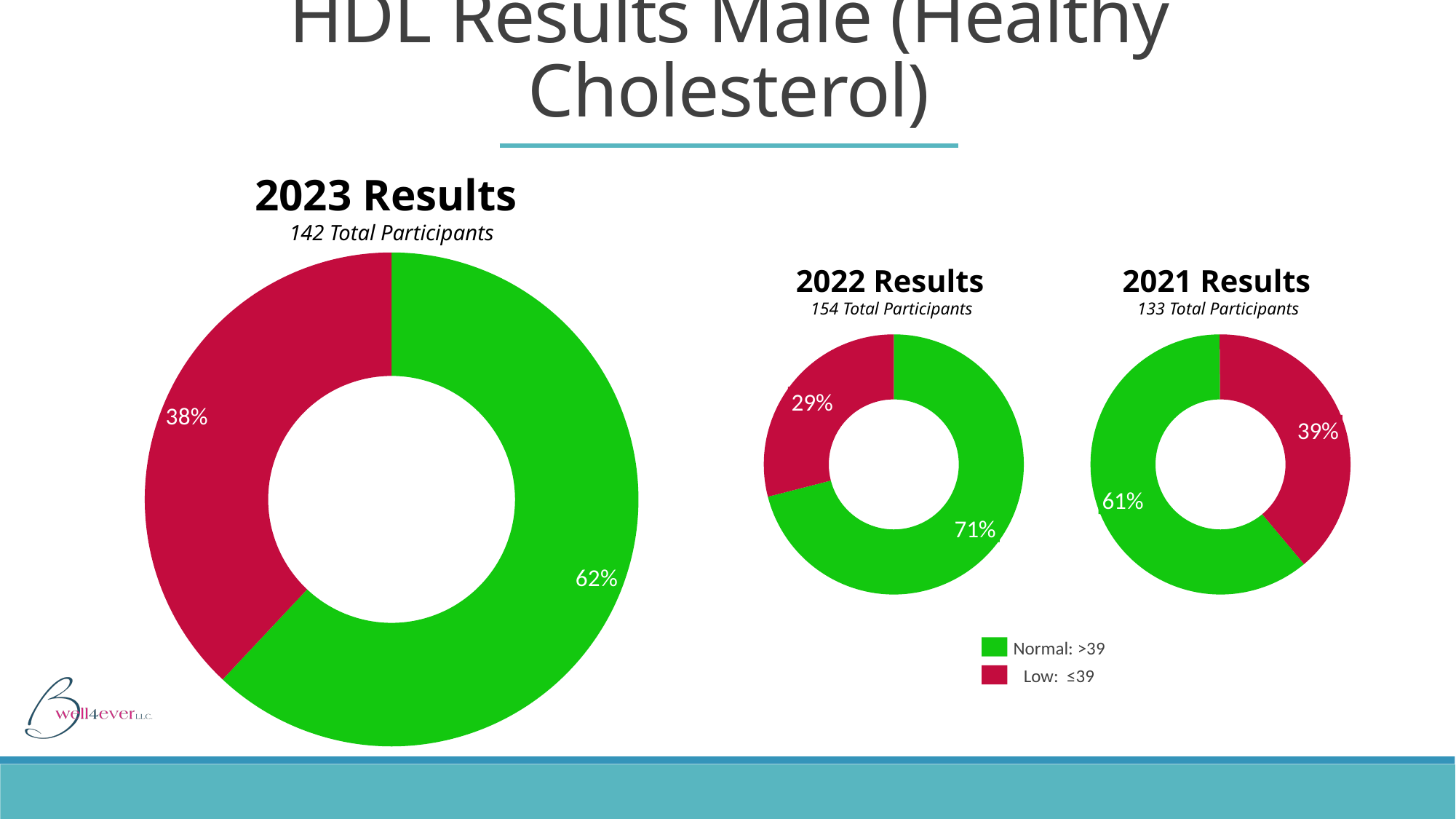
How many categories does the legend list for these charts? 2 In the 2023 Results chart, which category has the larger share, Normal or Low? Normal In the 2022 Results chart, what percentage of participants had Normal HDL? 71% How many total participants are reported for the 2022 Results chart? 154 In the 2023 Results chart, what percentage of participants had Low HDL? 38% In the 2023 Results chart, what percentage of participants had Normal HDL? 62% Which colour represents the Low (≤39) category in the charts? Red What kind of chart is used to show the 2023 Results? Doughnut chart In the 2021 Results chart, what percentage of participants had Normal HDL? 61% In the 2022 Results chart, what percentage of participants had Low HDL? 29% In the 2021 Results chart, what percentage of participants had Low HDL? 39% In the 2022 Results chart, what is the difference in percentage points between the Normal and Low shares? 42